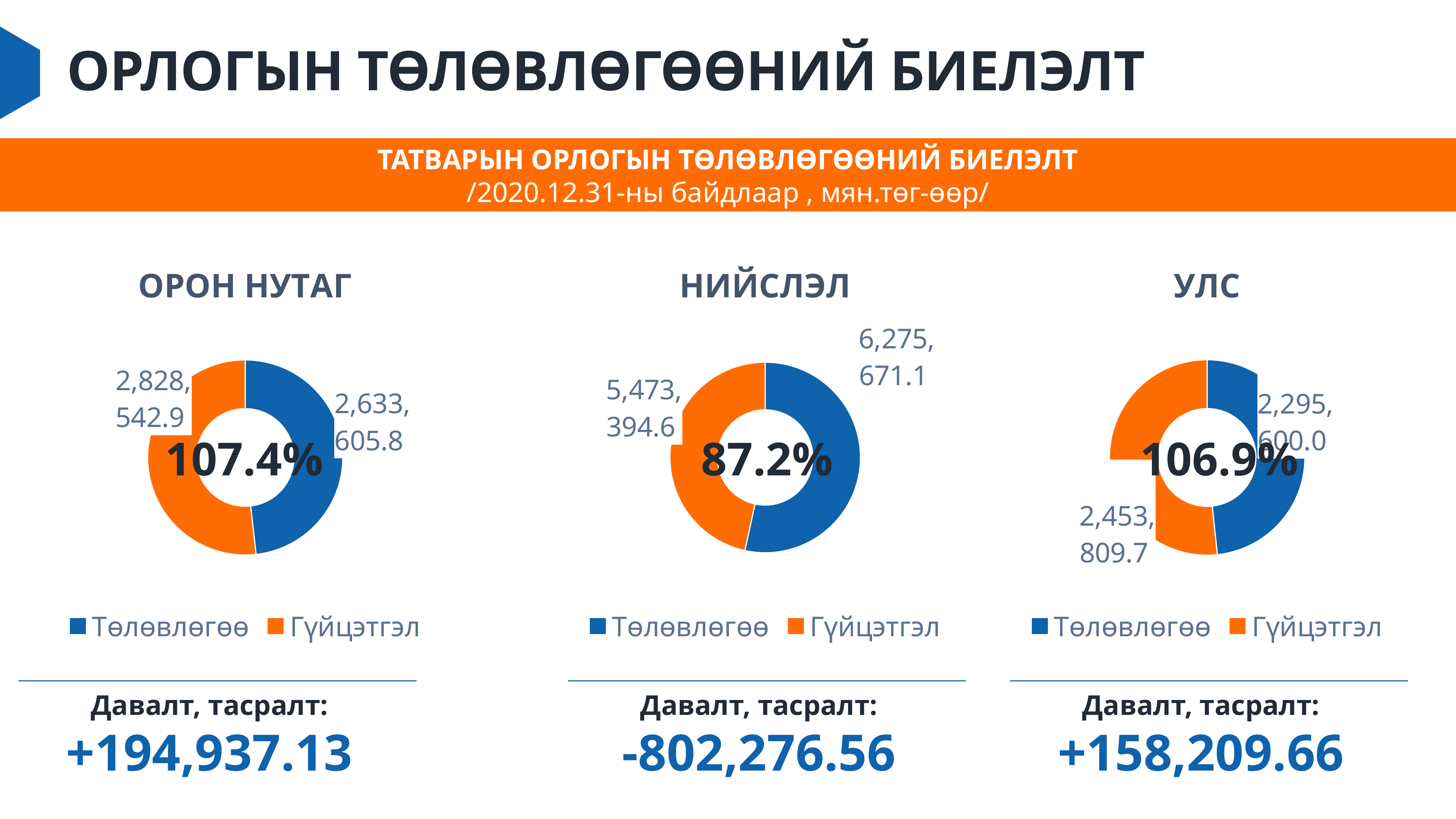
Which colour represents Гүйцэтгэл in the charts? Orange In the ОРОН НУТАГ chart, what is the value for Төлөвлөгөө? 2,633,605.8 In the НИЙСЛЭЛ chart, what is the value for Гүйцэтгэл? 5,473,394.6 How many series does the legend of the УЛС chart list? 2 In the НИЙСЛЭЛ chart, which is larger, Төлөвлөгөө or Гүйцэтгэл? Төлөвлөгөө What kind of chart is used for ОРОН НУТАГ? Donut (pie) chart In the ОРОН НУТАГ chart, which is larger, Төлөвлөгөө or Гүйцэтгэл? Гүйцэтгэл What percentage is shown in the centre of the НИЙСЛЭЛ chart? 87.2% In the УЛС chart, what is the value for Төлөвлөгөө? 2,295,600.0 In the ОРОН НУТАГ chart, what is the value for Гүйцэтгэл? 2,828,542.9 In the НИЙСЛЭЛ chart, what is the value for Төлөвлөгөө? 6,275,671.1 In the УЛС chart, what is the value for Гүйцэтгэл? 2,453,809.7